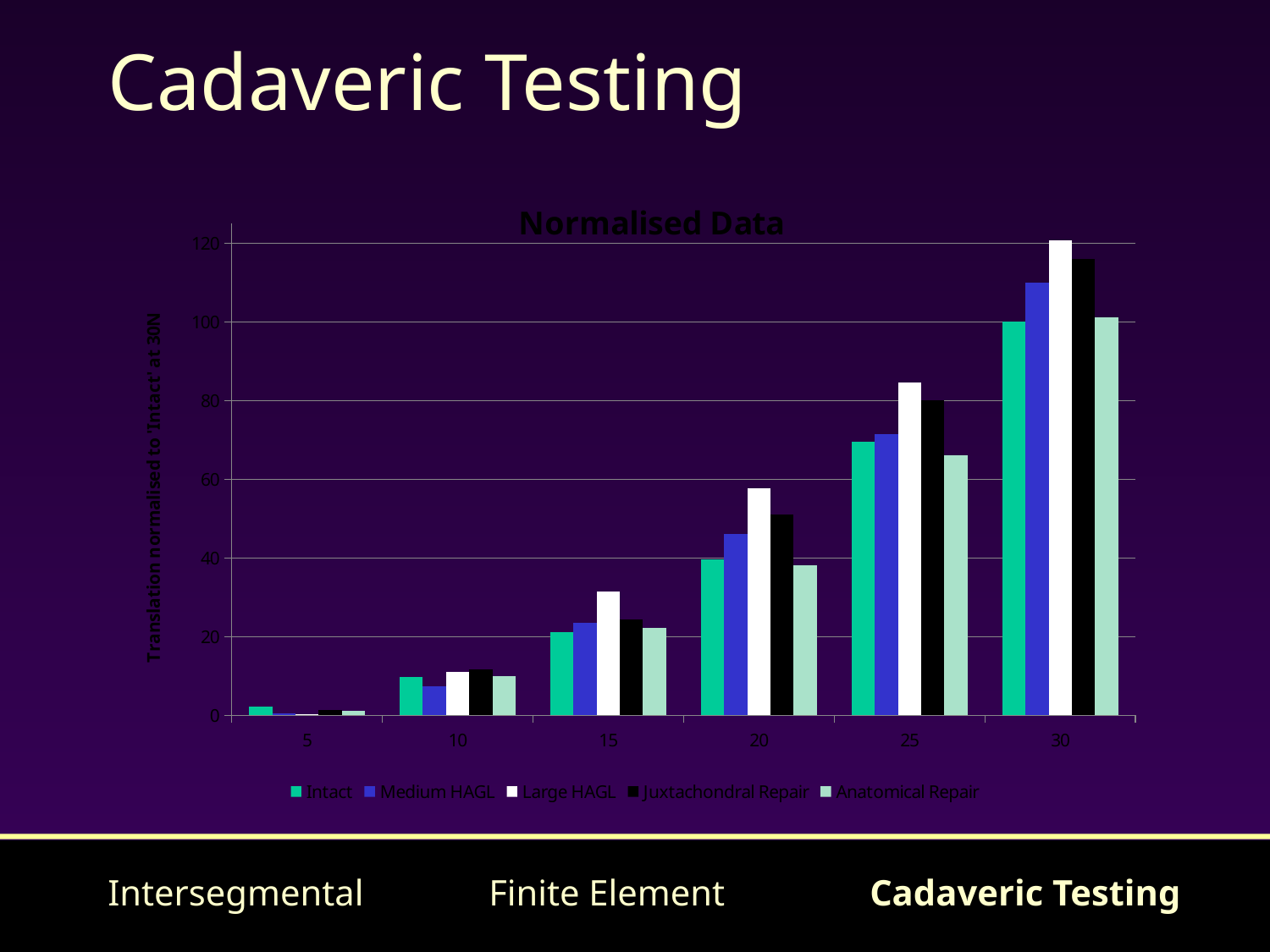
Which series has the highest bar at x = 30 in the 'Normalised Data' chart? Large HAGL Do the values of the Intact series rise or fall as x increases from 5 to 30? rise What kind of chart is shown under the title 'Normalised Data'? bar chart Is the value for Large HAGL at x = 25 greater or less than 80? greater What is the value of the Intact series at x = 30 in the 'Normalised Data' chart? 100 Is the value for Medium HAGL at x = 20 greater or less than 40? greater Is the value for Anatomical Repair at x = 20 greater or less than 40? less At x = 25, which is larger: Large HAGL or Intact? Large HAGL What is the y-axis label of the 'Normalised Data' chart? Translation normalised to 'Intact' at 30N How many categories are shown on the x axis of the 'Normalised Data' chart? 6 How many series does the legend of the 'Normalised Data' chart list? 5